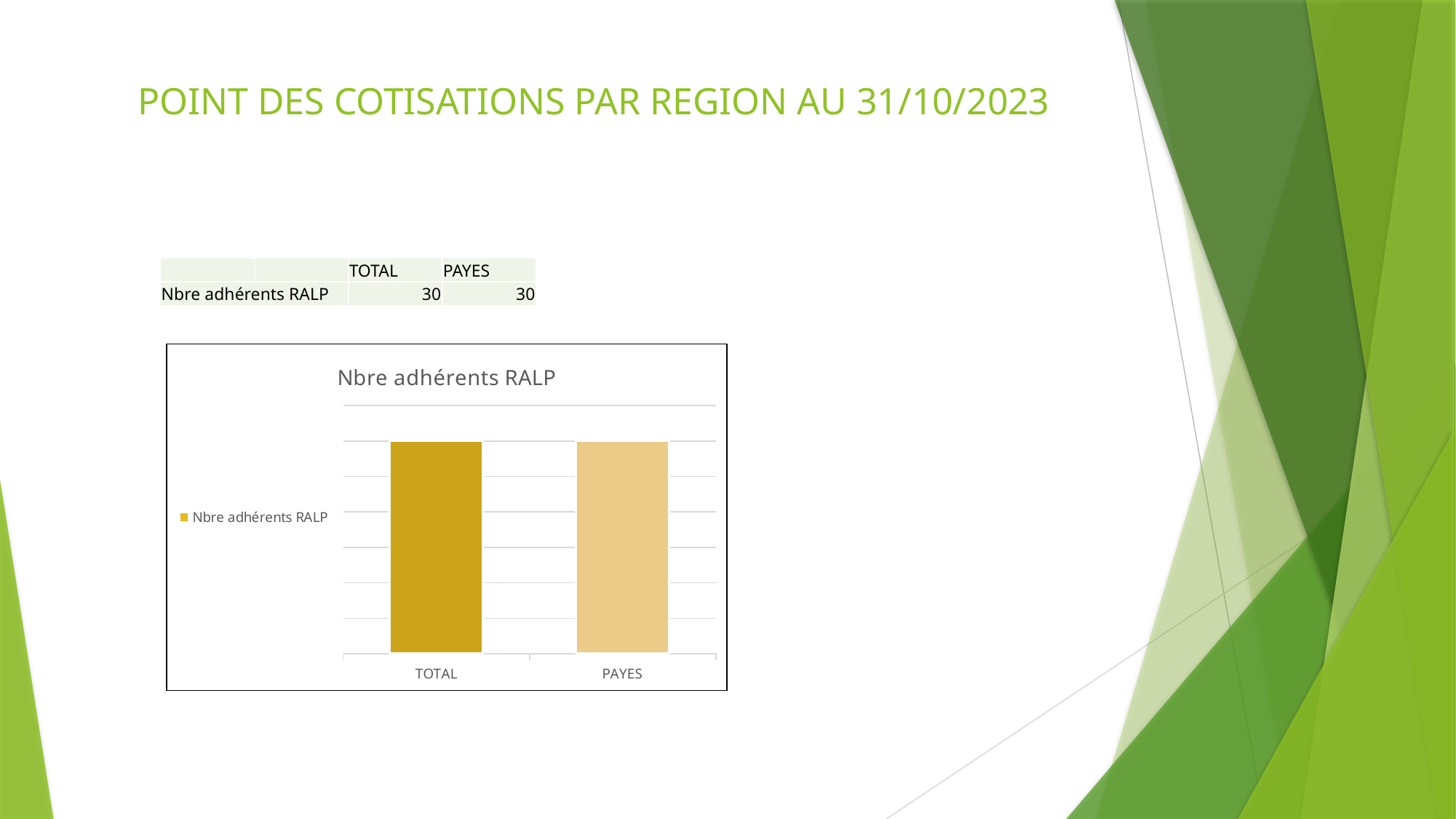
What is the title of the chart? Nbre adhérents RALP What is the difference between the TOTAL and PAYES values in the chart? 0 How many categories are shown on the x axis of the chart? 2 What are the two category labels on the x axis of the chart? TOTAL and PAYES How many series does the chart legend list? 1 What is the value for TOTAL in the Nbre adhérents RALP chart? 30 What kind of chart is shown on the slide? bar chart What is the value for PAYES in the Nbre adhérents RALP chart? 30